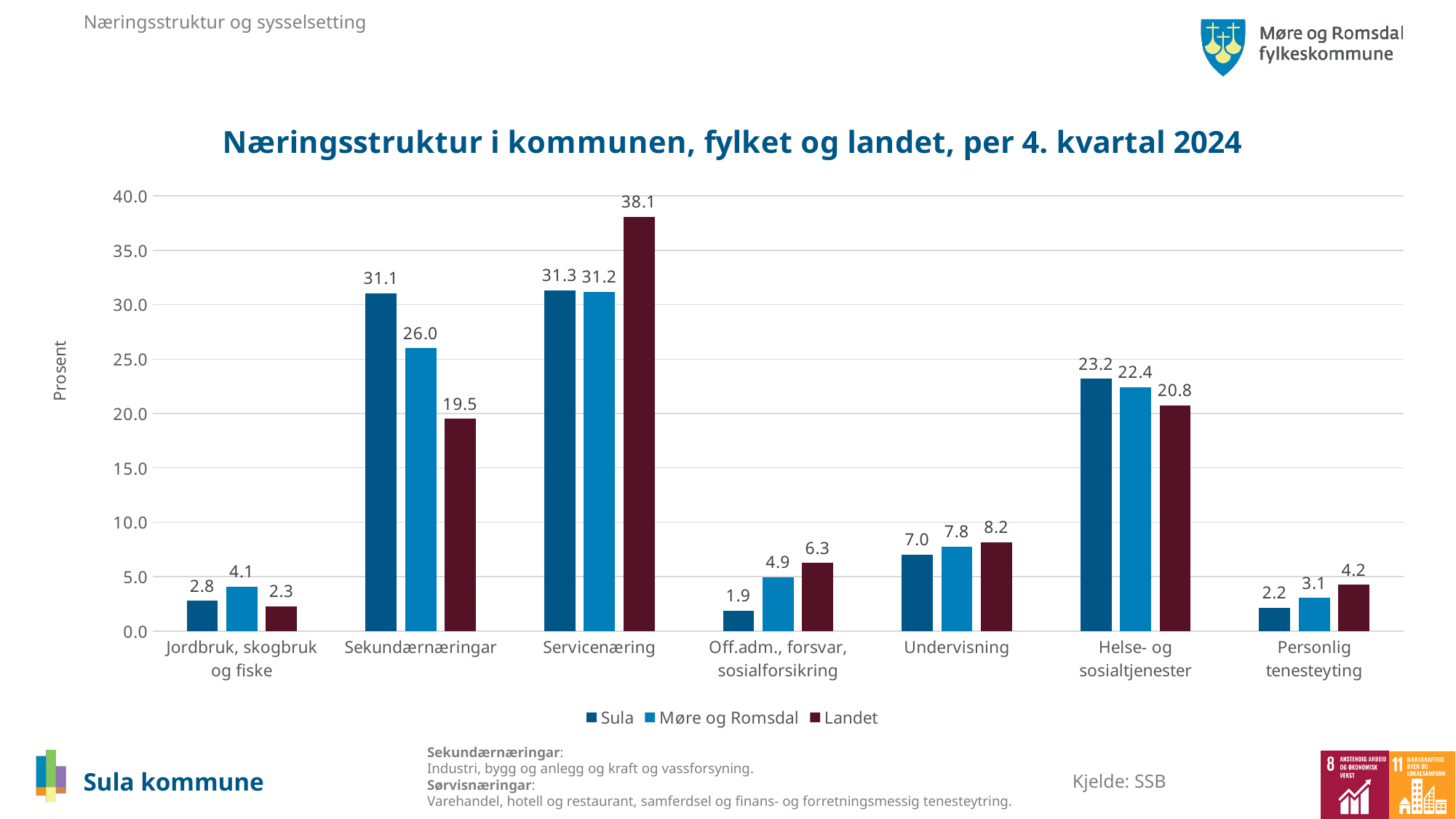
What is the value for Sula in Sekundærnæringar? 31.1 Is the value for Møre og Romsdal in Sekundærnæringar greater or less than 25.0? greater What is the title of the chart? Næringsstruktur i kommunen, fylket og landet, per 4. kvartal 2024 What is the difference between the Landet and Sula values in Sekundærnæringar? 11.6 Which is larger in Undervisning: the value for Sula or the value for Landet? Landet What is the value for Landet in Servicenæring? 38.1 How many series does the legend list? 3 What is the value for Møre og Romsdal in Helse- og sosialtjenester? 22.4 How many categories are shown on the x axis? 7 Which category has the highest value for Landet? Servicenæring Which category has the lowest value for Sula? Off.adm., forsvar, sosialforsikring What kind of chart is shown on the slide? Bar chart